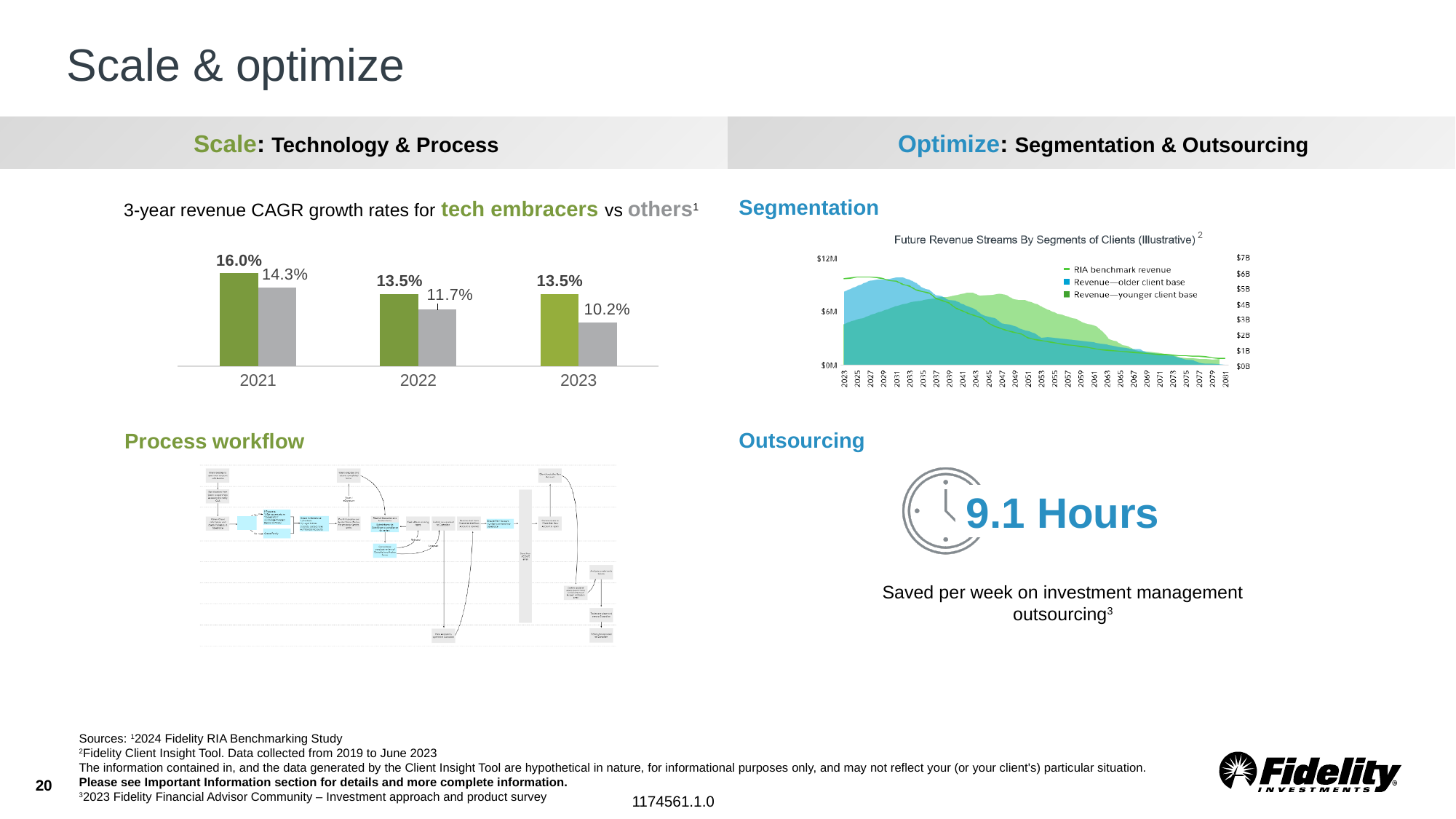
In the bar chart of 3-year revenue CAGR growth rates, do the values for others rise or fall from 2021 to 2023? fall In the bar chart of 3-year revenue CAGR growth rates, what is the difference between tech embracers and others in 2021? 1.7 percentage points In the bar chart of 3-year revenue CAGR growth rates, in which year is the tech embracers value highest? 2021 In the bar chart of 3-year revenue CAGR growth rates, which group has the larger value in 2022, tech embracers or others? tech embracers In the bar chart of 3-year revenue CAGR growth rates, what is the value for others in 2022? 11.7% How many series does the legend list in the Future Revenue Streams By Segments of Clients chart? 3 In the bar chart of 3-year revenue CAGR growth rates, what is the difference between tech embracers and others in 2023? 3.3 percentage points How many years are shown on the x axis of the bar chart of 3-year revenue CAGR growth rates? 3 What kind of chart is used to show the 3-year revenue CAGR growth rates for tech embracers vs others? bar chart In the bar chart of 3-year revenue CAGR growth rates, in which year is the others value lowest? 2023 In the bar chart of 3-year revenue CAGR growth rates, what is the value for others in 2023? 10.2% In the bar chart of 3-year revenue CAGR growth rates, what is the value for tech embracers in 2021? 16.0%